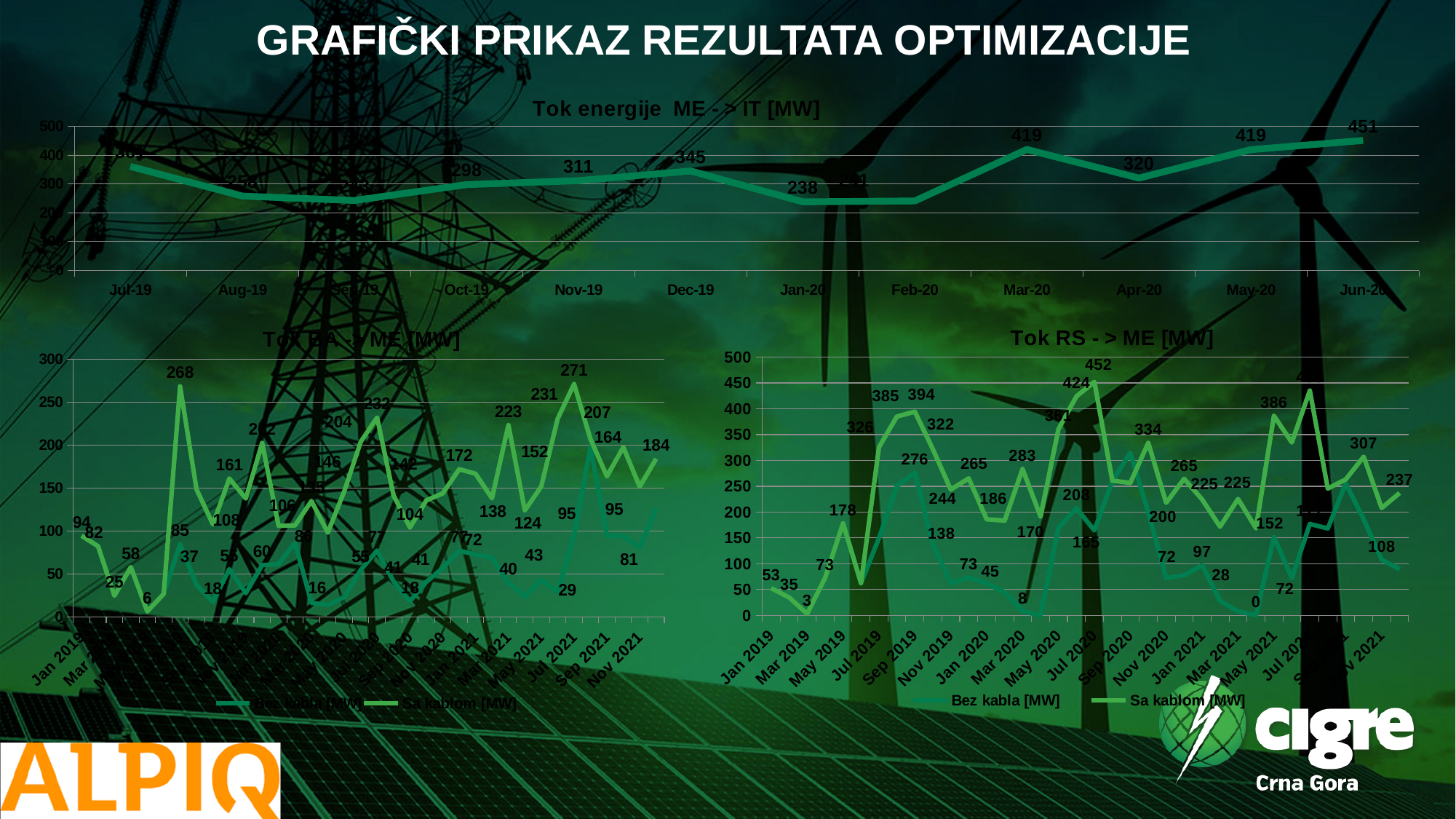
In the 'Tok energije ME -> IT [MW]' chart, which month has the highest value? Jun-20 In the 'Tok energije ME -> IT [MW]' chart, what is the difference between the values for Jun-20 and Dec-19? 106 In the 'Tok energije ME -> IT [MW]' chart, what is the value for Dec-19? 345 How many series does the legend of the 'Tok RS -> ME [MW]' chart list? 2 In the 'Tok RS -> ME [MW]' chart, what is the highest labelled value? 452 What type of chart is the 'Tok energije ME -> IT [MW]' chart? line chart What are the two legend entries of the 'Tok BA -> ME [MW]' chart? Bez kabla [MW] and Sa kablom [MW] In the 'Tok energije ME -> IT [MW]' chart, which is larger, the value for Nov-19 or Dec-19? Dec-19 In the 'Tok energije ME -> IT [MW]' chart, what is the value for Jun-20? 451 In the 'Tok energije ME -> IT [MW]' chart, what is the difference between the values for Mar-20 and Apr-20? 99 In the 'Tok energije ME -> IT [MW]' chart, is the value for Jan-20 greater or less than 300? less How many months are shown on the x axis of the 'Tok energije ME -> IT [MW]' chart? 12